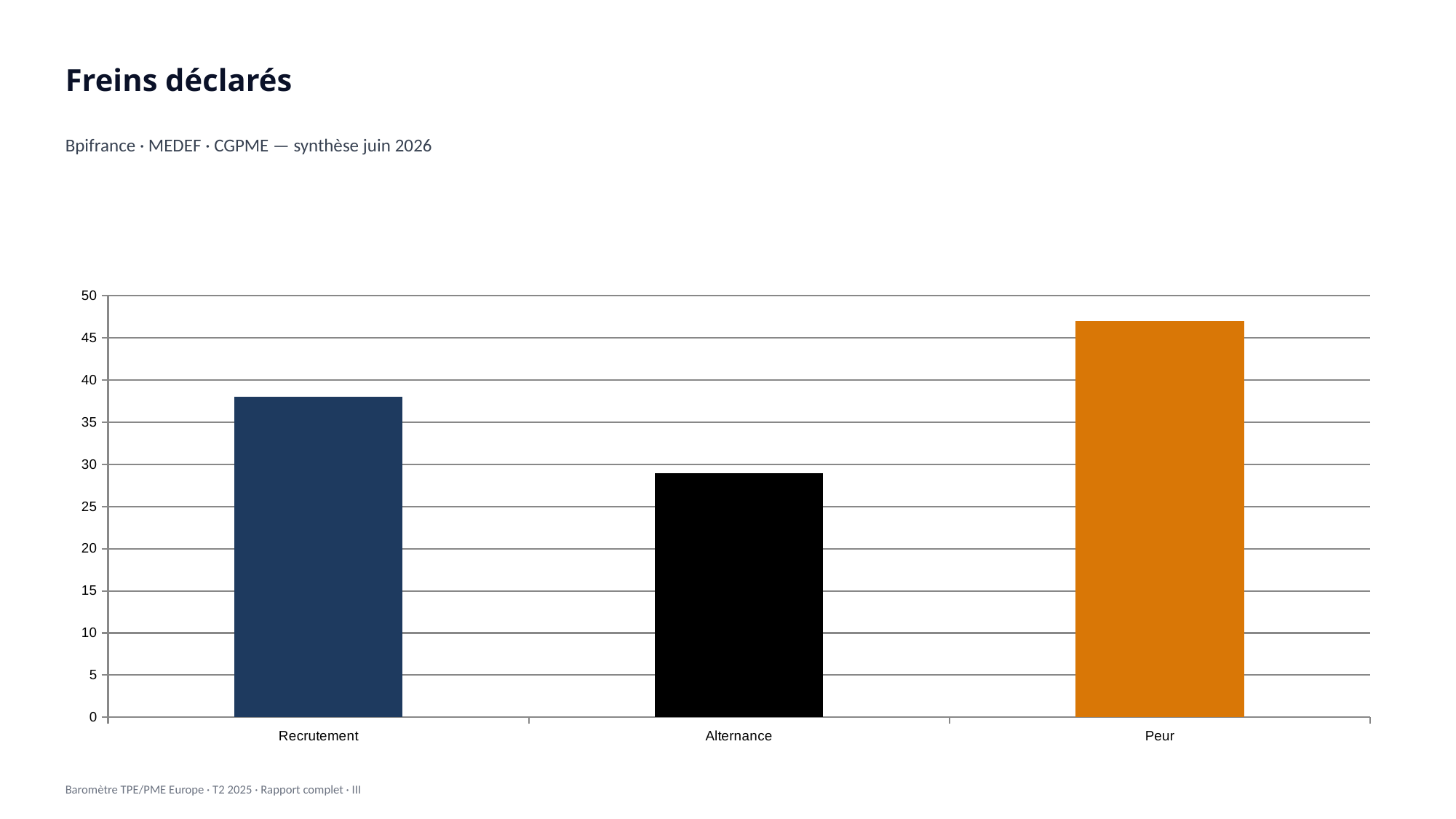
Which category has the lowest bar? Alternance What colour is the bar for Peur? orange How many categories are shown on the x axis of the chart? 3 Which is larger, the value for Peur or the value for Recrutement? Peur Is the value for Recrutement greater or less than 40? less What is the title of the slide containing the chart? Freins déclarés Which category has the highest bar? Peur What kind of chart is shown on the slide? bar chart Is the value for Peur greater or less than 45? greater Is the value for Recrutement greater or less than 35? greater Which is larger, the value for Recrutement or the value for Alternance? Recrutement